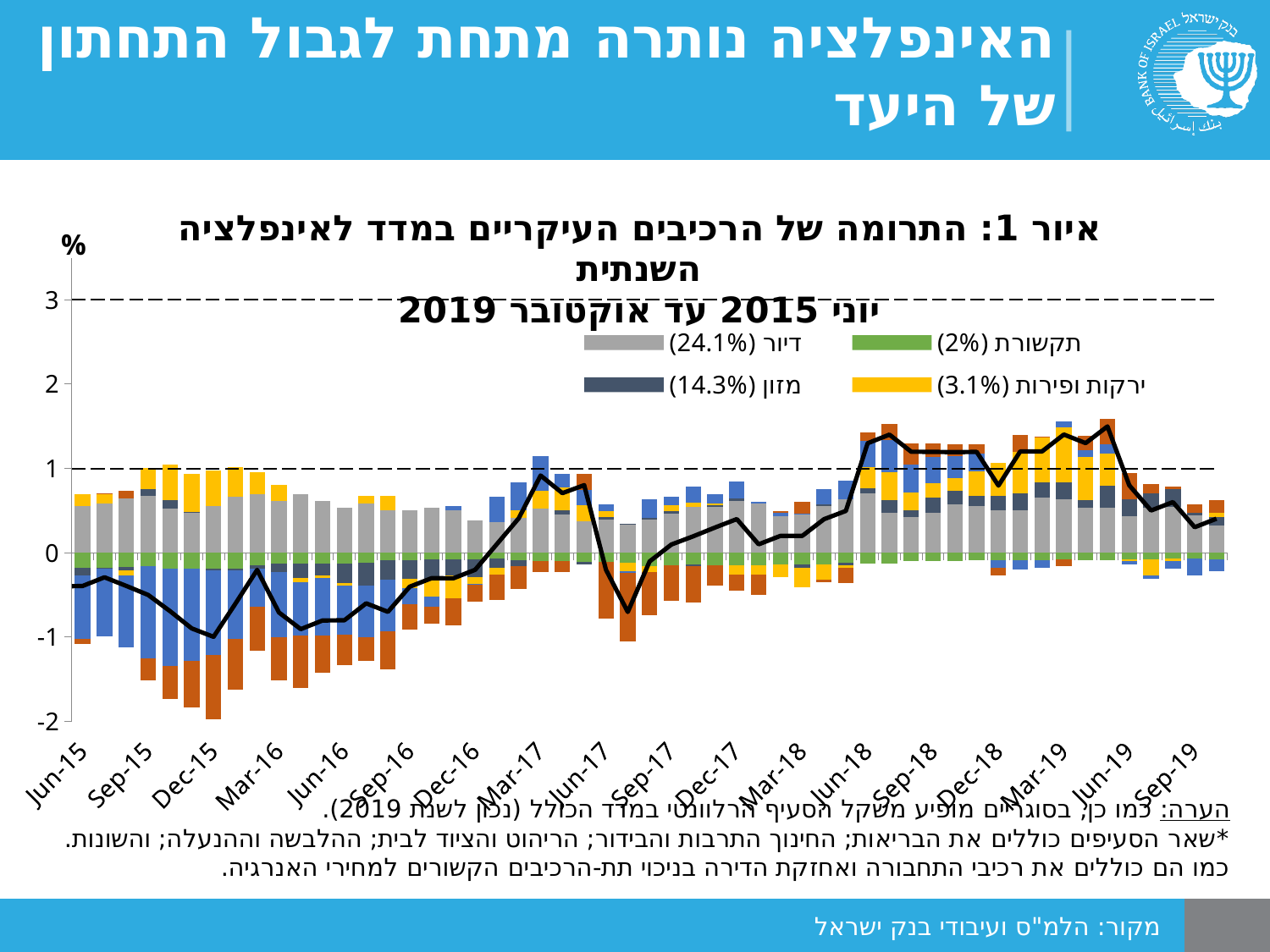
Is the value of the black line at Sep-19 greater or less than 1? less What unit is shown on the y axis of the chart? % How many date labels are shown on the x axis? 18 Does the black line rise or fall between Jun-15 and Dec-15? fall Is the value of the black line at Sep-18 greater or less than 1? greater Is the value of the black line at Jun-15 greater or less than 0? less Which is larger, the black line value at Jun-18 or at Jun-15? Jun-18 Which is larger, the black line value at Jun-19 or at Dec-15? Jun-19 What kind of chart is shown on the slide? Stacked bar chart with a line What percentage is shown in the legend next to דיור? 24.1%